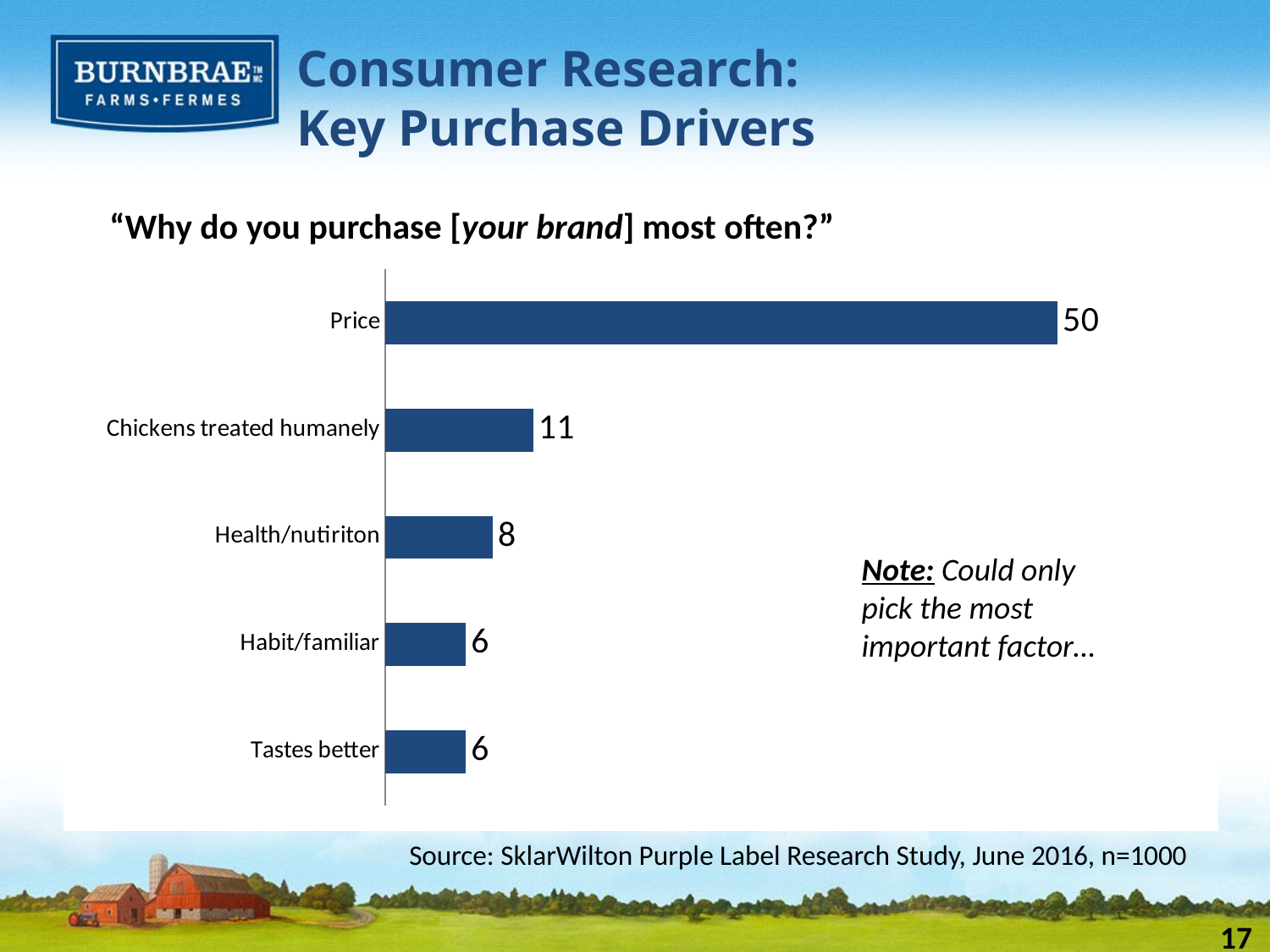
What is the difference between the values for Chickens treated humanely and Health/nutiriton? 3 What kind of chart is shown on the slide? Bar chart Which is larger, the value for Health/nutiriton or the value for Tastes better? Health/nutiriton What is the difference between the values for Price and Chickens treated humanely? 39 What is the value for Chickens treated humanely? 11 What is the value for Price? 50 How many categories are shown in the chart? 5 What is the value for Health/nutiriton? 8 Which category has the highest value? Price What is the value for Habit/familiar? 6 What question is the chart based on, as shown above the chart? "Why do you purchase [your brand] most often?" Which two categories share the same value of 6? Habit/familiar and Tastes better